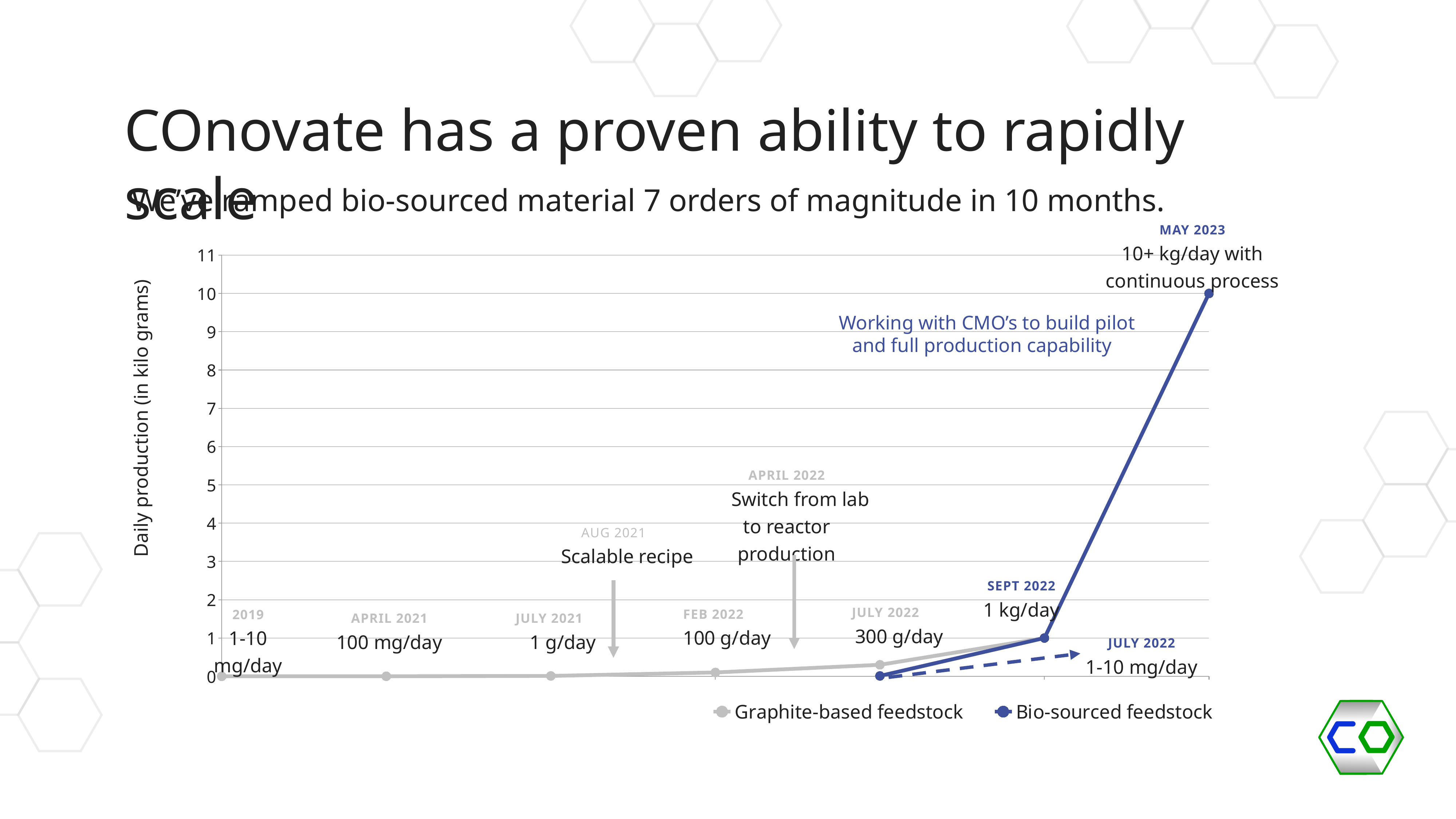
What daily production is annotated for April 2021? 100 mg/day What kind of chart is shown on the slide? line chart What daily production is annotated for July 2022 on the graphite-based feedstock line? 300 g/day How many series does the chart legend list? 2 Is the value of the bio-sourced feedstock point at May 2023 greater or less than 5 on the vertical axis? greater What daily production is annotated for July 2021? 1 g/day Does the bio-sourced feedstock line rise or fall from July 2022 to May 2023? rise What daily production is annotated for Feb 2022? 100 g/day What daily production is annotated for Sept 2022? 1 kg/day What daily production is annotated for May 2023? 10+ kg/day with continuous process What are the two series named in the chart legend? Graphite-based feedstock and Bio-sourced feedstock What is the label on the chart's vertical axis? Daily production (in kilo grams)